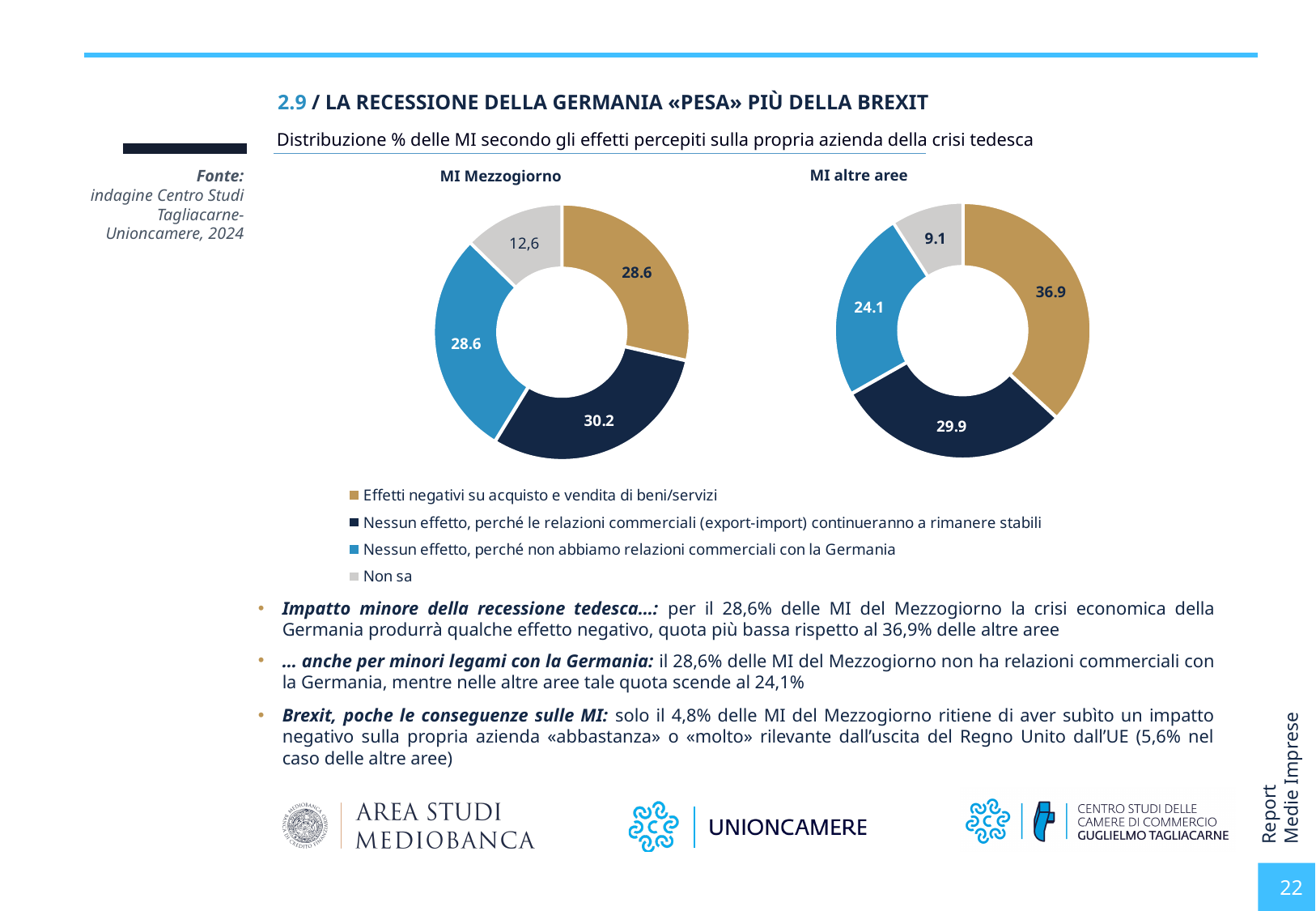
In the MI altre aree chart, what is the value for "Effetti negativi su acquisto e vendita di beni/servizi"? 36.9 In the MI altre aree chart, what is the value for "Nessun effetto, perché non abbiamo relazioni commerciali con la Germania"? 24.1 How many categories does the MI Mezzogiorno chart show? 4 What kind of chart is used for MI Mezzogiorno and MI altre aree? Pie (donut) chart In the MI altre aree chart, which category has the smallest share? Non sa What is the difference between the "Effetti negativi su acquisto e vendita di beni/servizi" value in the MI altre aree chart and the same category in the MI Mezzogiorno chart? 8.3 In the MI altre aree chart, which category has the largest share? Effetti negativi su acquisto e vendita di beni/servizi In the MI Mezzogiorno chart, what is the value for "Nessun effetto, perché le relazioni commerciali (export-import) continueranno a rimanere stabili"? 30.2 Which chart has the larger value for "Nessun effetto, perché non abbiamo relazioni commerciali con la Germania": MI Mezzogiorno or MI altre aree? MI Mezzogiorno How many entries does the shared legend list? 4 In the MI Mezzogiorno chart, what is the value for "Non sa"? 12,6 In the MI Mezzogiorno chart, which category has the smallest share? Non sa